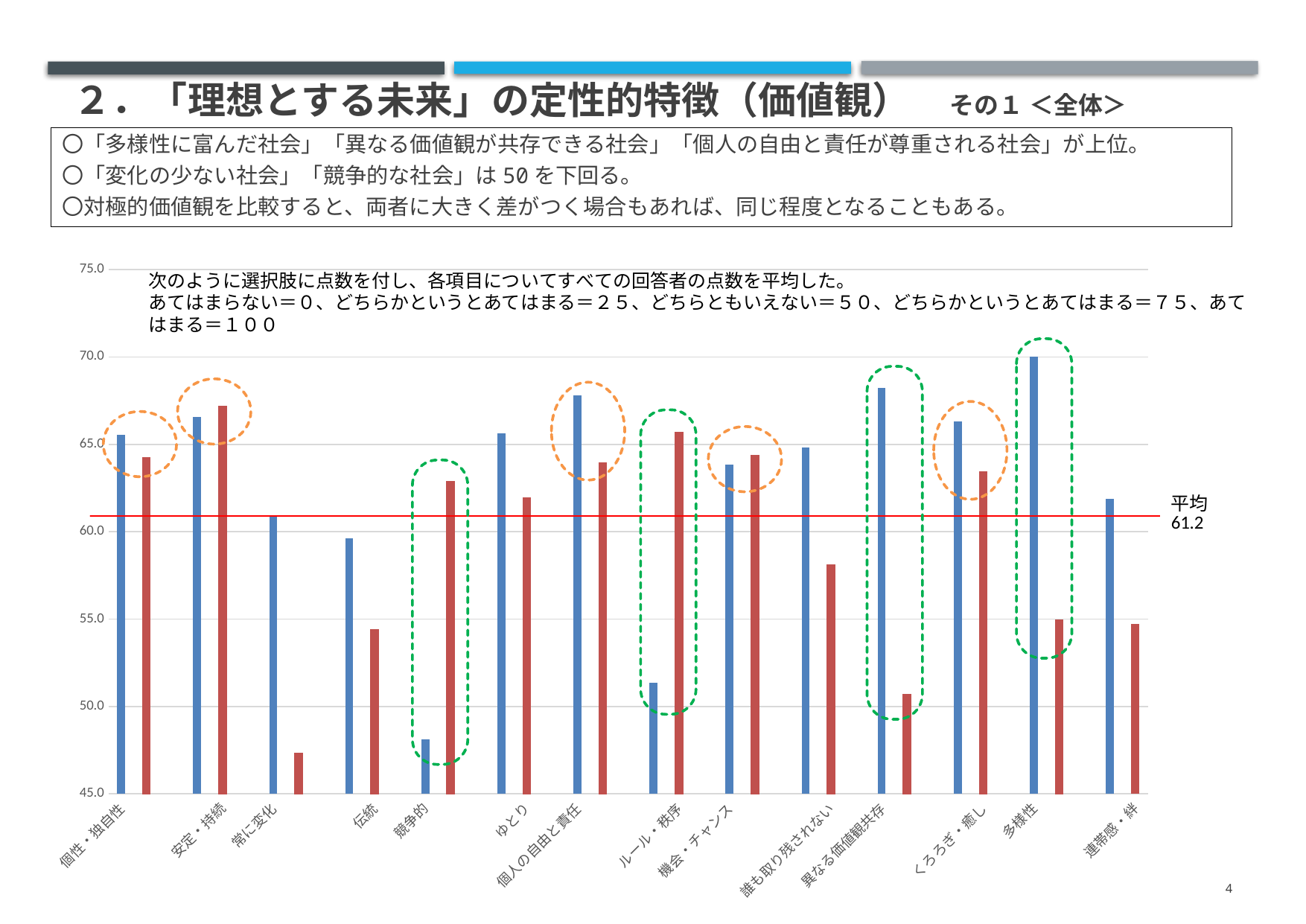
Is the blue bar for 競争的 greater or less than 50? less Is the red bar for 異なる価値観共存 greater or less than 55? less Is the red bar for 誰も取り残されない greater or less than 60? less For 競争的, which bar is taller, the blue bar or the red bar? the red bar What value is marked by the horizontal red line labelled 平均 on the chart? 61.2 Which category has the shortest red bar? 常に変化 For 多様性, which bar is taller, the blue bar or the red bar? the blue bar Which category has the shortest blue bar? 競争的 What kind of chart is shown on the slide? bar chart Which category has the tallest blue bar? 多様性 How many categories are shown along the x axis of the chart? 14